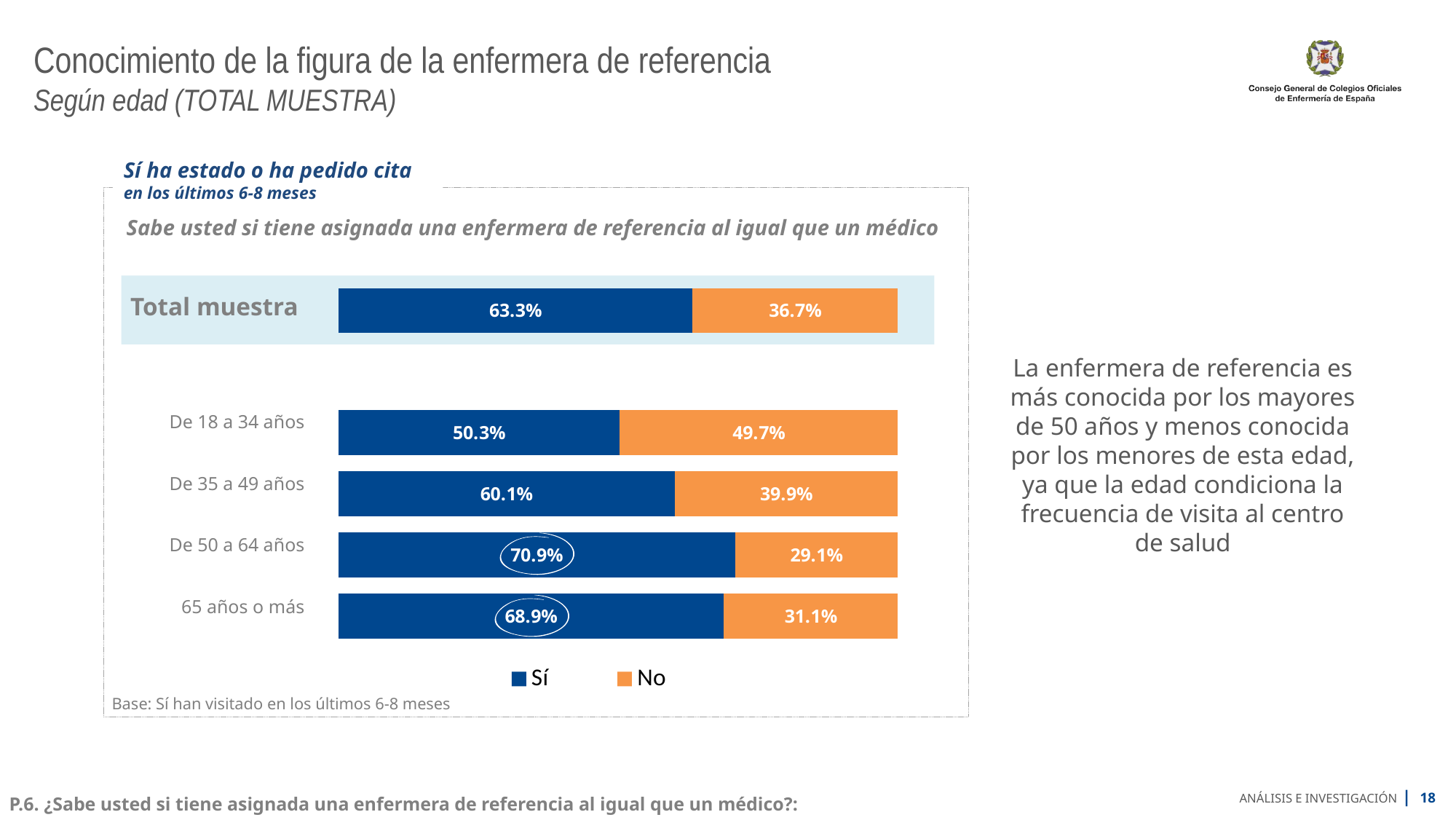
What is the 'No' value for 'De 50 a 64 años'? 29.1% Which age group has the lowest 'Sí' value? De 18 a 34 años What is the difference between the 'Sí' values for 'De 50 a 64 años' and 'De 18 a 34 años'? 20.6% How many series does the legend list? 2 What kind of chart is shown on the slide? Stacked bar chart Which colour represents the 'No' series in the chart? Orange Which age group has the highest 'Sí' value? De 50 a 64 años What is the 'Sí' value for 'Total muestra'? 63.3% Which is larger: the 'No' value for 'De 35 a 49 años' or the 'No' value for '65 años o más'? De 35 a 49 años How many age groups are shown below the 'Total muestra' bar? 4 What is the 'Sí' value for 'De 18 a 34 años'? 50.3% What is the 'No' value for '65 años o más'? 31.1%